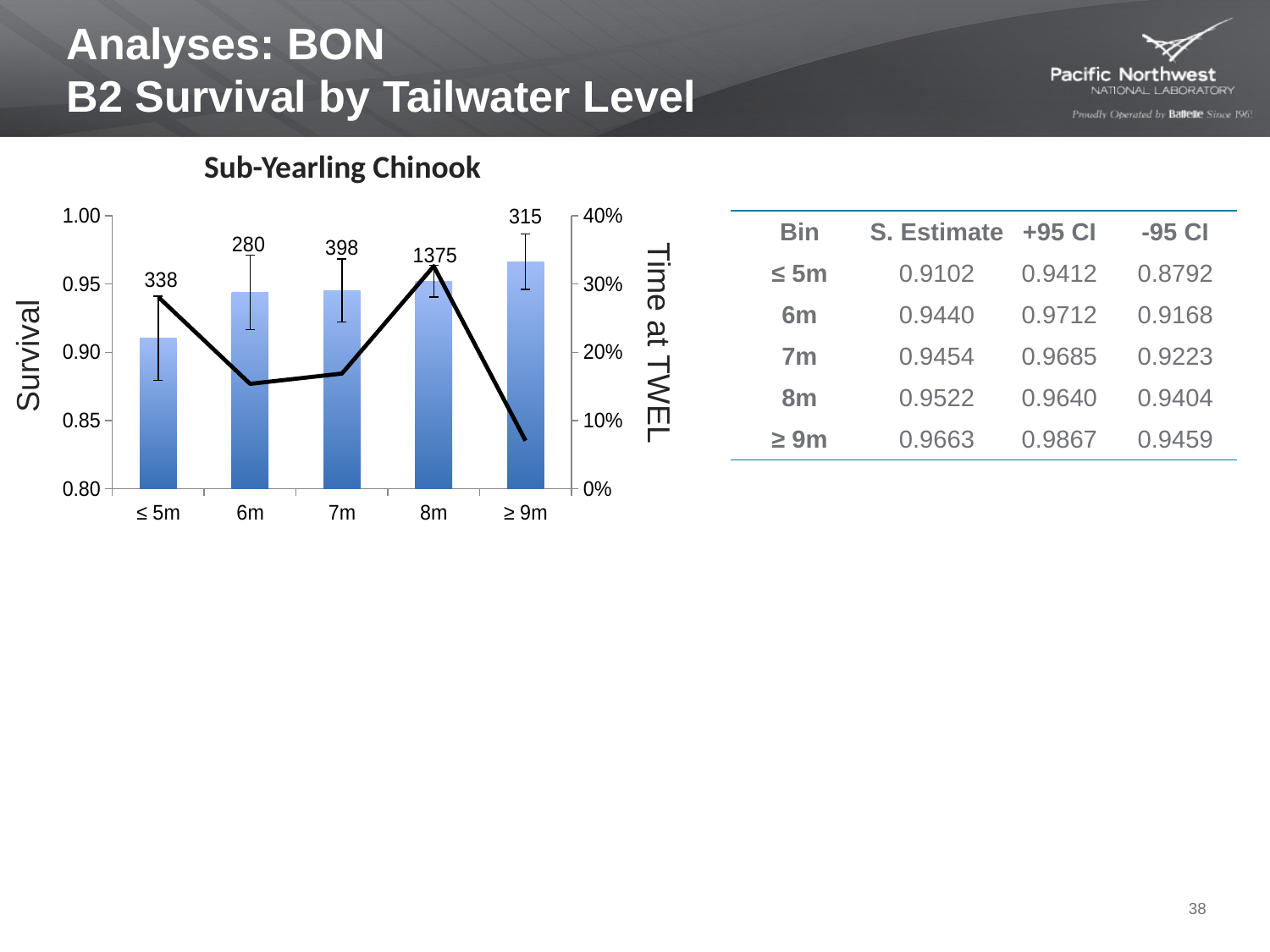
How many tailwater level bins are shown on the x axis of the chart? 5 Which bin has the lowest survival bar? ≤ 5m Which bin has the highest survival bar? ≥ 9m What number is printed above the 8m bar? 1375 What is the difference between the survival estimates for the ≥ 9m and ≤ 5m bins? 0.0561 Is the Time at TWEL value for the ≥ 9m bin greater or less than 10%? less Do the survival bars rise or fall as tailwater level increases from ≤ 5m to ≥ 9m? Rise What is the title of the chart? Sub-Yearling Chinook Which bin has the highest Time at TWEL value on the line? 8m What number is printed above the ≥ 9m bar? 315 What is the survival estimate for the 6m bin? 0.9440 What kind of chart is shown on the slide? Combination bar and line chart